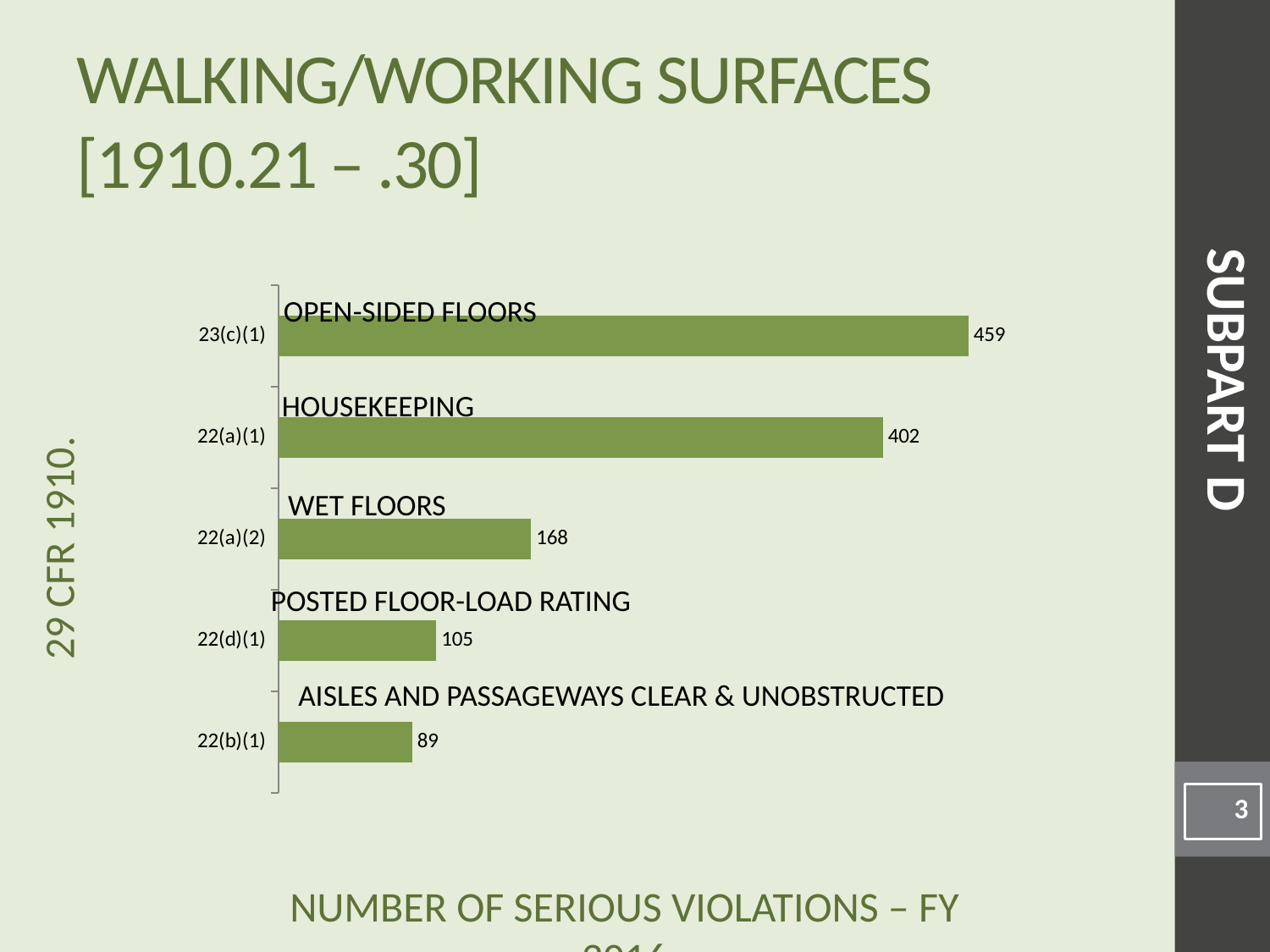
What is the difference between the values for Wet Floors and Posted Floor-Load Rating? 63 What is the value shown for 22(b)(1) (Aisles and Passageways Clear & Unobstructed)? 89 What type of chart is shown on the slide? Bar chart What is the difference between the values for 23(c)(1) and 22(a)(1)? 57 What is the value shown for 22(a)(2) (Wet Floors)? 168 What is the number of serious violations for 22(a)(1) (Housekeeping)? 402 Which has more serious violations, Housekeeping or Wet Floors? Housekeeping What is the value shown for 22(d)(1) (Posted Floor-Load Rating)? 105 Which category has the highest number of serious violations? 23(c)(1) Open-Sided Floors How many categories are shown in the chart? 5 Which category has the lowest number of serious violations? 22(b)(1) Aisles and Passageways Clear & Unobstructed What is the number of serious violations for 23(c)(1) (Open-Sided Floors)? 459